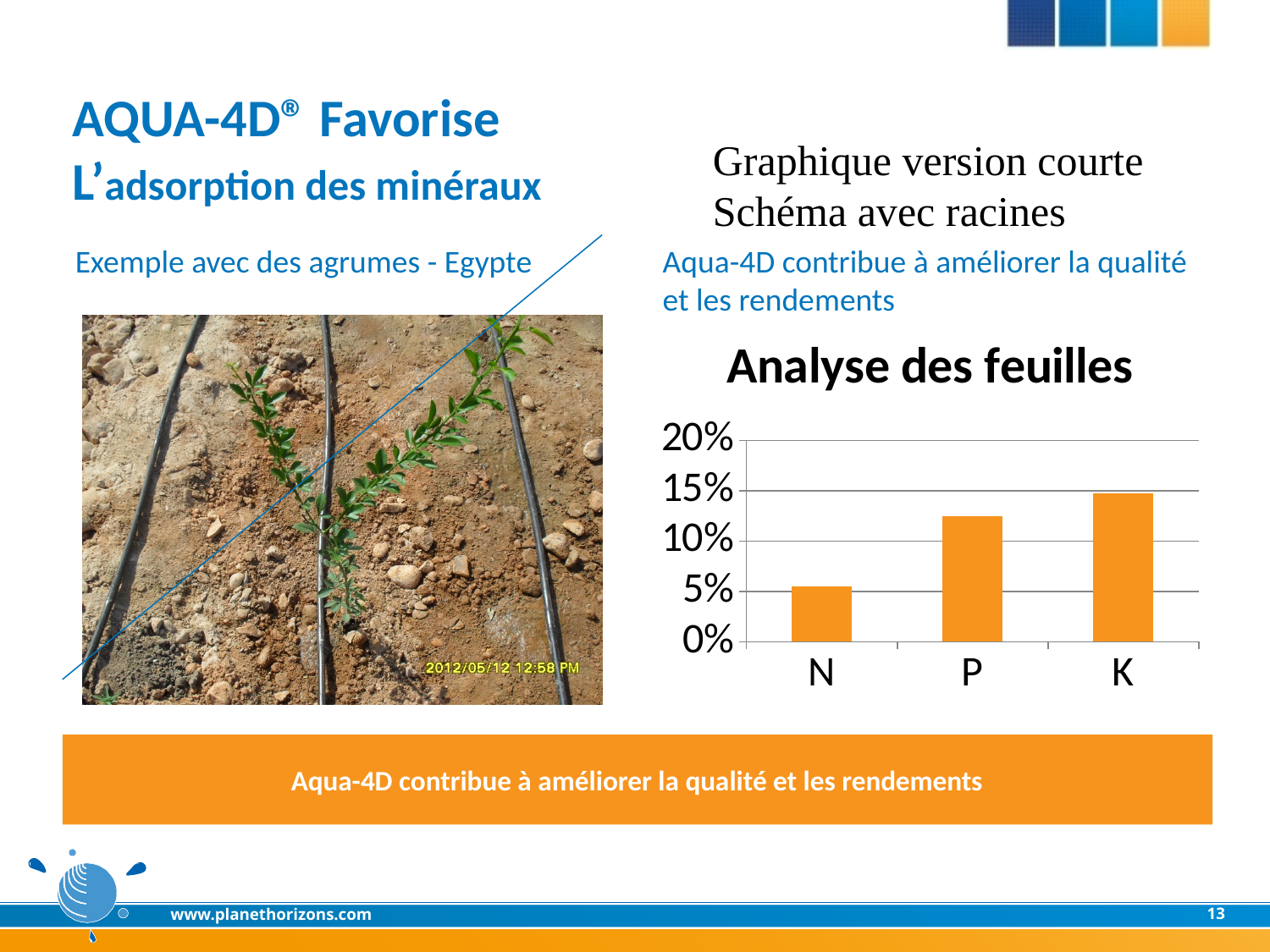
What is the title of the chart on the slide? Analyse des feuilles Which category has the highest value in the "Analyse des feuilles" chart? K In the "Analyse des feuilles" chart, is the value for P greater or less than 10%? greater How many categories are shown on the x axis of the "Analyse des feuilles" chart? 3 Which category has the lowest value in the "Analyse des feuilles" chart? N In the "Analyse des feuilles" chart, is the value for K greater or less than 10%? greater In the "Analyse des feuilles" chart, is the value for P greater or less than 15%? less In the "Analyse des feuilles" chart, which is larger, the value for P or the value for N? P Do the values in the "Analyse des feuilles" chart rise or fall from N to K along the x axis? rise What kind of chart is shown under the title "Analyse des feuilles"? bar chart What colour are the bars in the "Analyse des feuilles" chart? orange